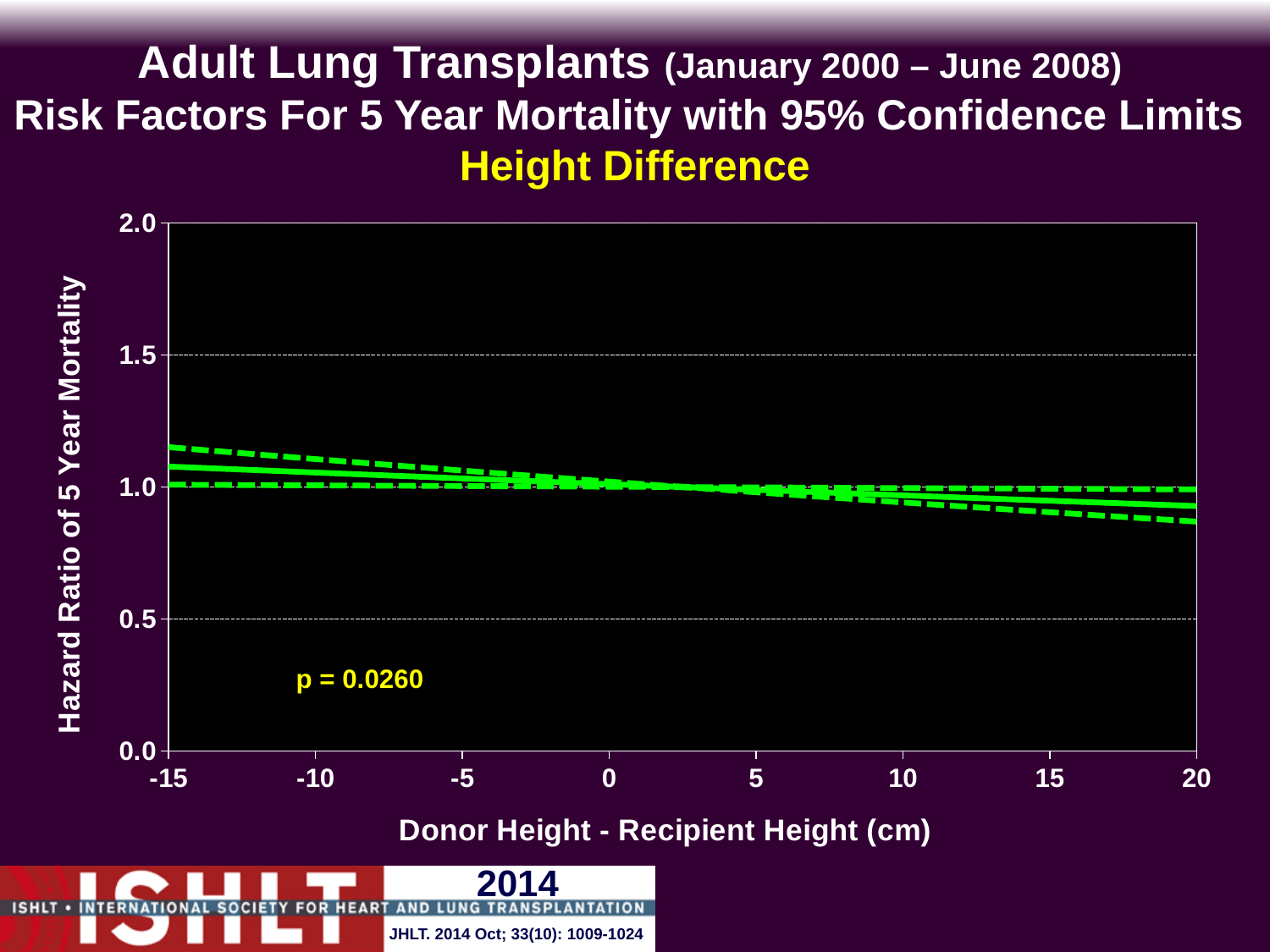
How many tick labels are shown on the x axis? 8 Is the hazard ratio (solid line) at a height difference of -15 cm greater or less than 1.0? greater Is the upper 95% confidence limit at a height difference of -15 cm greater or less than 1.5? less Does the hazard ratio of 5 year mortality rise or fall as the donor height minus recipient height increases from -15 to 20 cm? fall How many lines are plotted on the chart (including the confidence limit lines)? 3 Is the hazard ratio at a height difference of -15 cm larger or smaller than at 20 cm? larger Is the lower 95% confidence limit at a height difference of 20 cm greater or less than 1.0? less What p-value is printed on the chart? p = 0.0260 What kind of chart is shown on the slide? line chart What is the highest value labelled on the y axis? 2.0